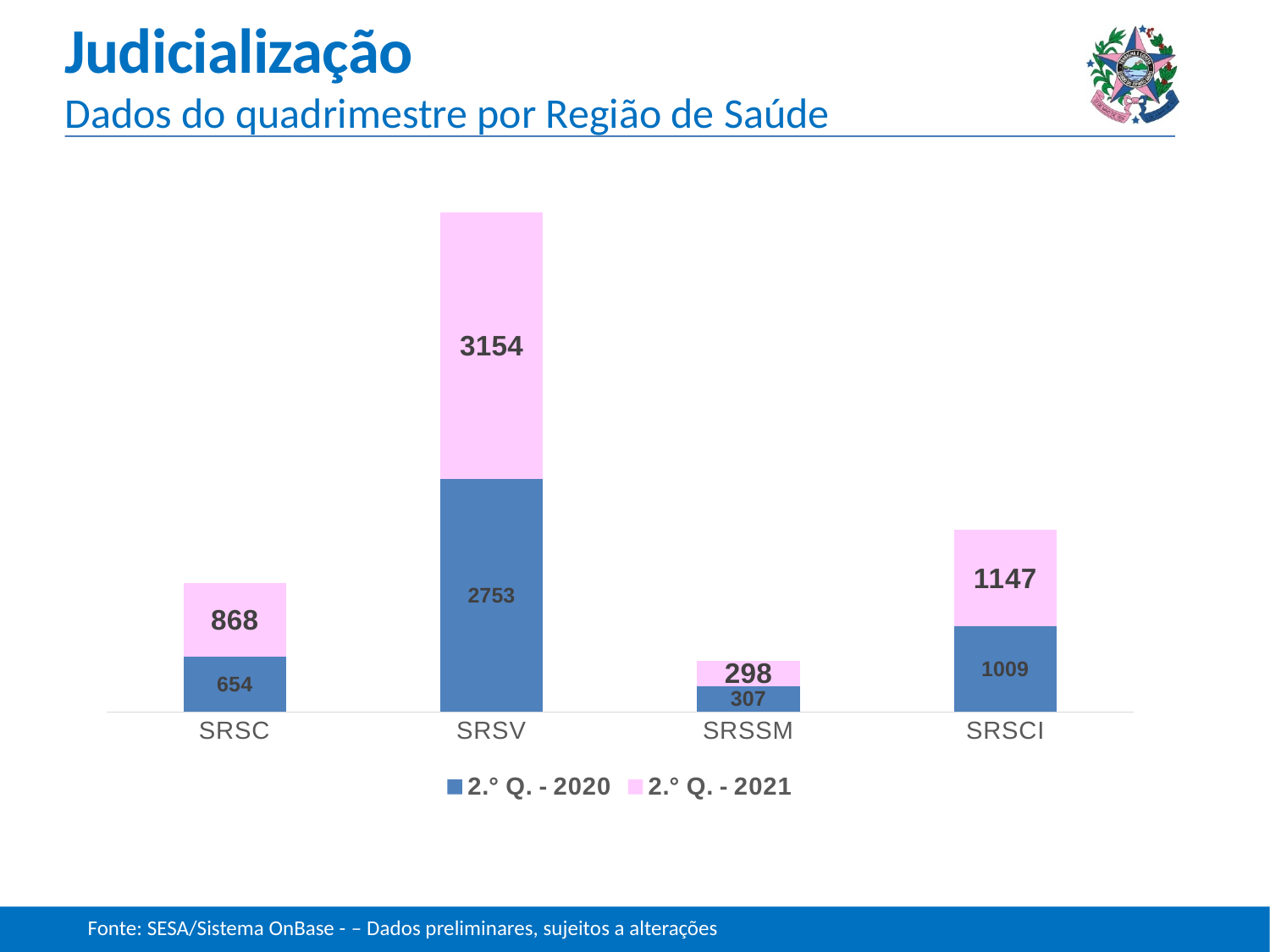
What is the value for SRSSM in the 2.° Q. - 2020 series? 307 What is the value for SRSV in the 2.° Q. - 2021 series? 3154 What kind of chart is shown on the slide? Stacked bar chart What is the total of the stacked bar for SRSC? 1522 What is the value for SRSC in the 2.° Q. - 2020 series? 654 What is the value for SRSCI in the 2.° Q. - 2021 series? 1147 Which region has the lowest value in the 2.° Q. - 2021 series? SRSSM Which is larger for SRSCI: the 2.° Q. - 2020 value or the 2.° Q. - 2021 value? 2.° Q. - 2021 How many series does the legend list? 2 What is the difference between the 2.° Q. - 2021 and 2.° Q. - 2020 values for SRSV? 401 Which region has the highest value in the 2.° Q. - 2020 series? SRSV How many regions are shown on the x axis? 4